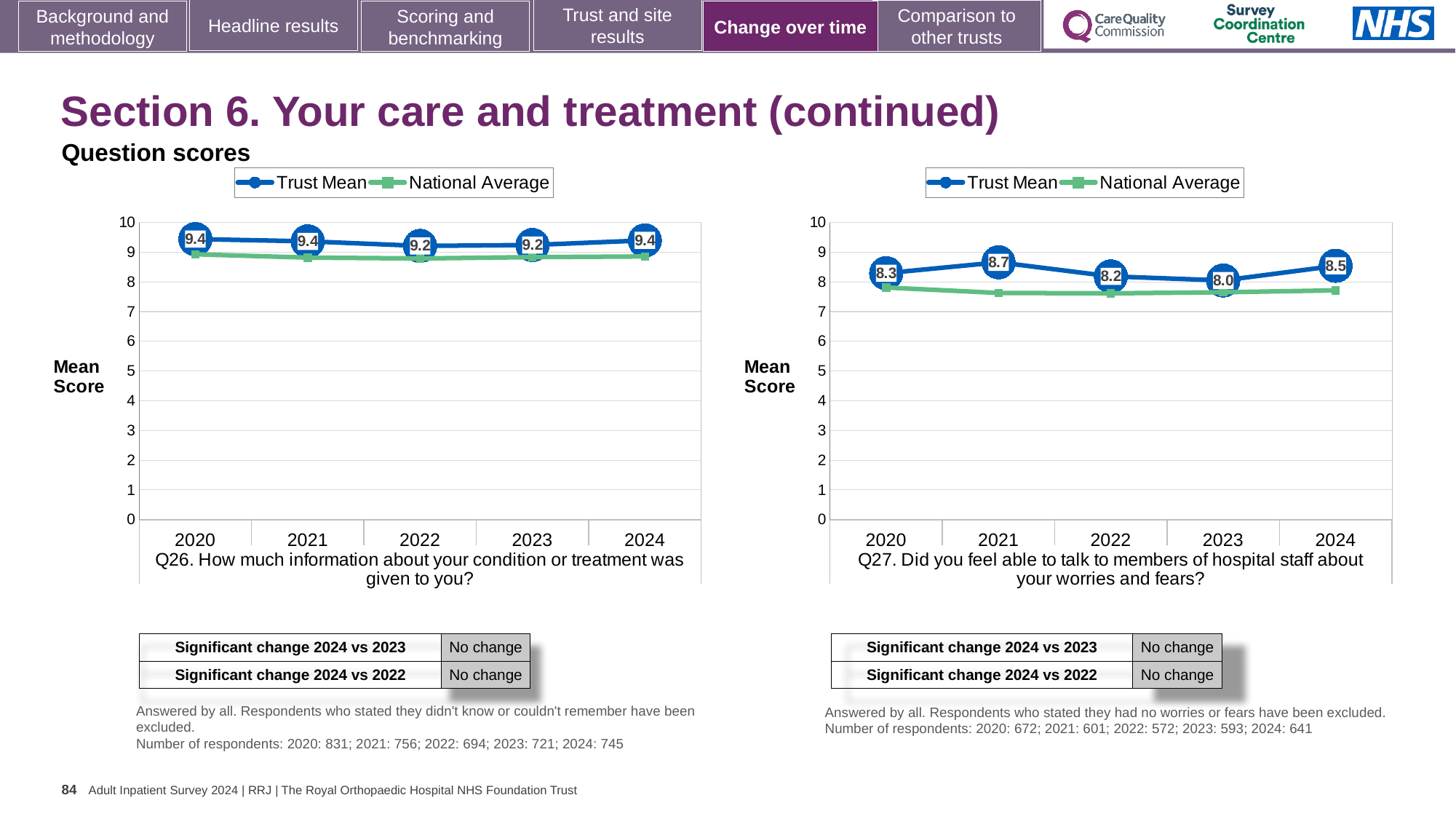
In the Q27 chart (right), which year has the highest Trust Mean? 2021 In the Q27 chart (right), is the National Average for 2024 greater or less than 8? less In the Q26 chart (left), is the National Average for 2020 greater or less than 8? greater In the Q26 chart (left), is the Trust Mean for 2021 larger or smaller than the Trust Mean for 2022? larger How many years are shown on the x axis of the Q26 chart (left)? 5 In the Q27 chart (right), what is the difference between the Trust Mean in 2021 and in 2023? 0.7 In the Q27 chart (right), which year has the lowest Trust Mean? 2023 In the Q26 chart (left), what is the difference between the Trust Mean in 2020 and in 2022? 0.2 What type of chart is used for Q26 (left)? Line chart In the Q26 chart (left), what is the Trust Mean for 2024? 9.4 In the Q27 chart (right), what is the Trust Mean for 2021? 8.7 How many series does the legend of the Q27 chart (right) list? 2